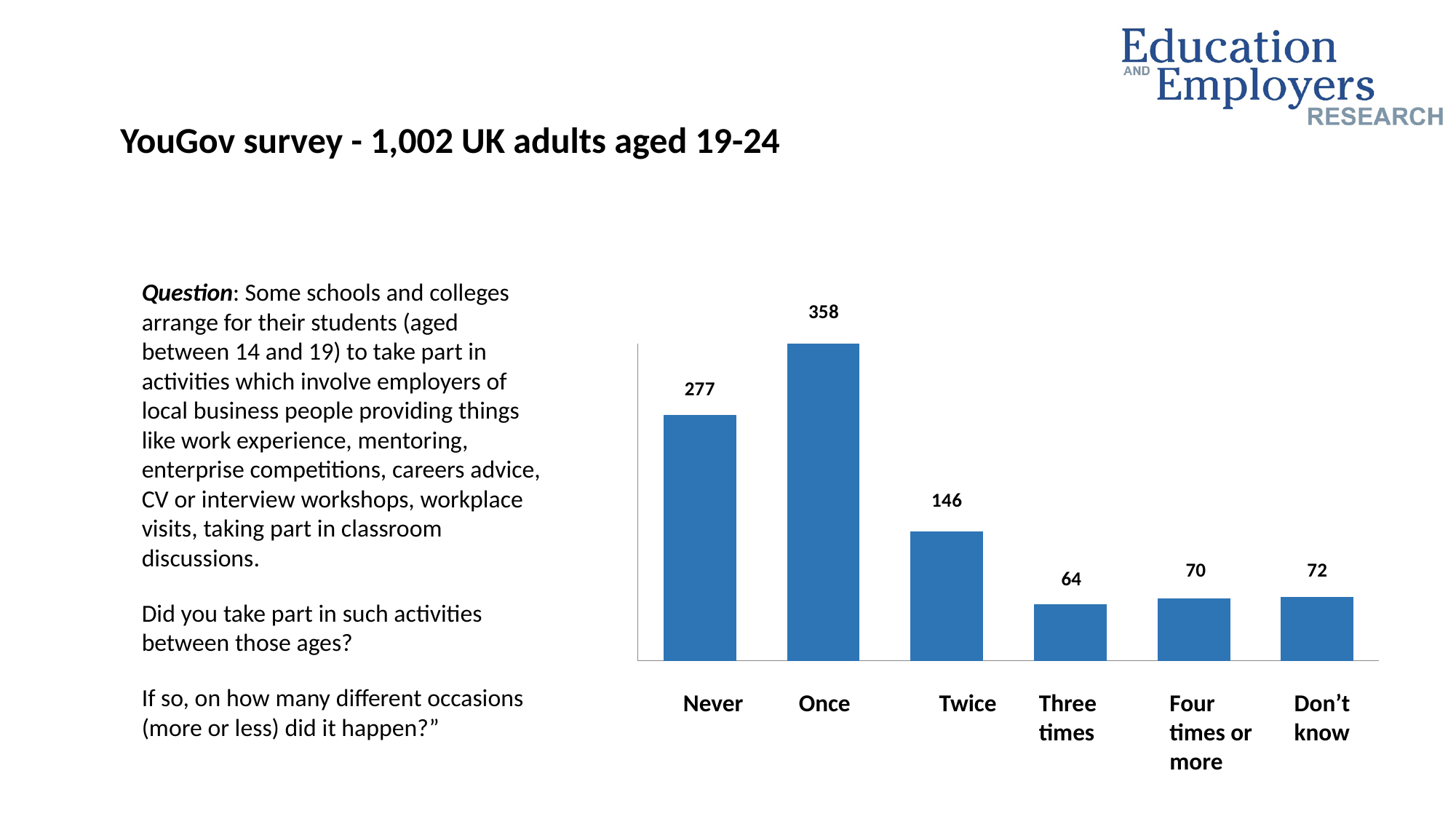
What is the value for Don't know? 72 What is the value for Three times? 64 What is the value for Once? 358 Which is larger, the value for Twice or the value for Four times or more? Twice What is the value for Twice? 146 What kind of chart is shown on the slide? Bar chart What is the difference between the values for Once and Never? 81 Which category has the highest value? Once What is the difference between the values for Never and Twice? 131 What is the value for Never? 277 How many categories are shown on the chart? 6 Which category has the lowest value? Three times